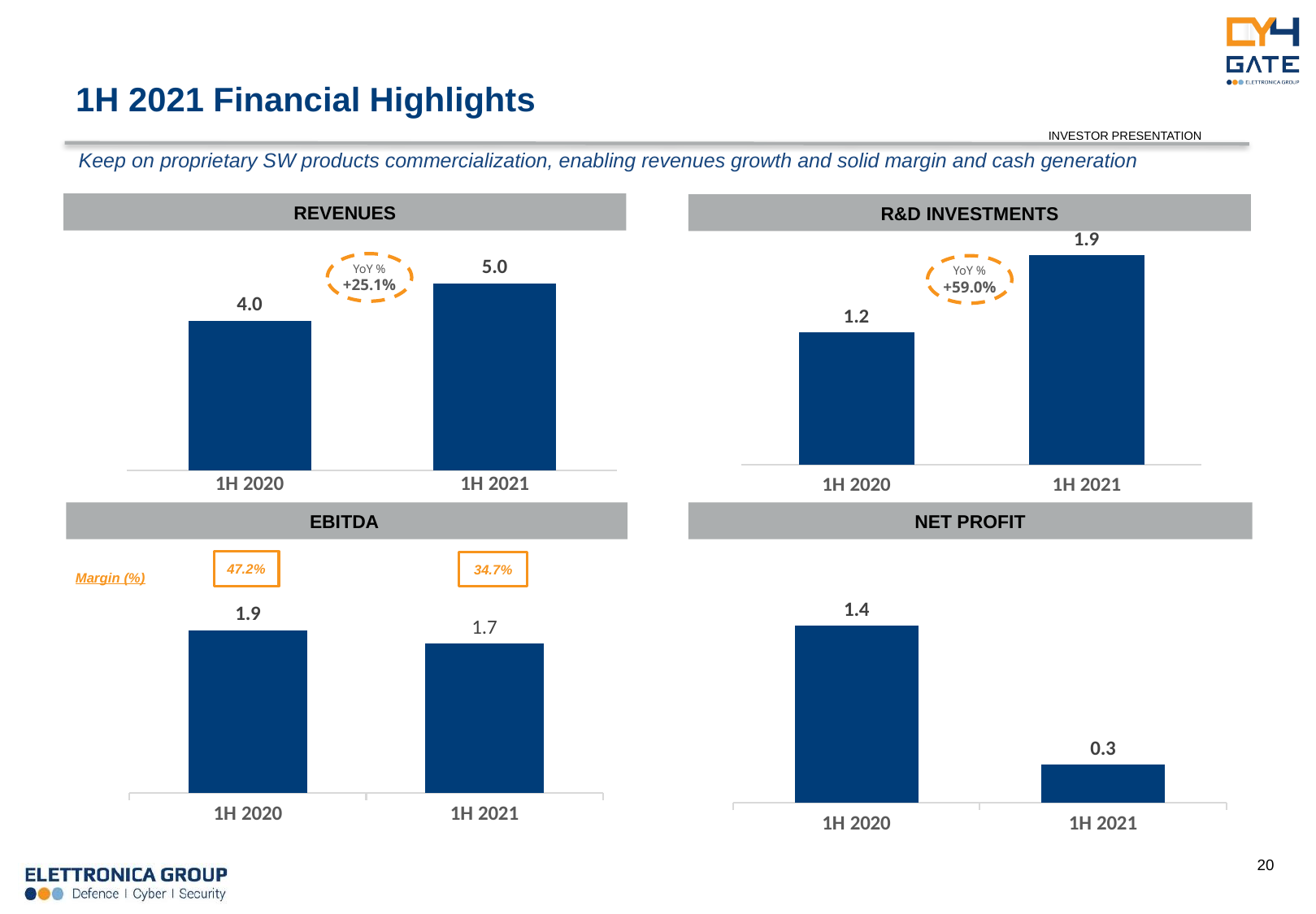
What kind of chart is the REVENUES chart? Bar chart In the NET PROFIT chart, which period has the highest value? 1H 2020 How many bars are plotted in the R&D INVESTMENTS chart? 2 In the R&D INVESTMENTS chart, what is the value for 1H 2020? 1.2 In the REVENUES chart, what is the difference between the 1H 2021 and 1H 2020 values? 1.0 In the R&D INVESTMENTS chart, which period has the lowest value? 1H 2020 In the EBITDA chart, what is the value for 1H 2020? 1.9 In the EBITDA chart, what is the margin (%) shown for 1H 2021? 34.7% In the REVENUES chart, what is the value for 1H 2021? 5.0 In the NET PROFIT chart, what is the value for 1H 2021? 0.3 In the NET PROFIT chart, what is the difference between the 1H 2020 and 1H 2021 values? 1.1 In the EBITDA chart, which is larger, the value for 1H 2020 or 1H 2021? 1H 2020